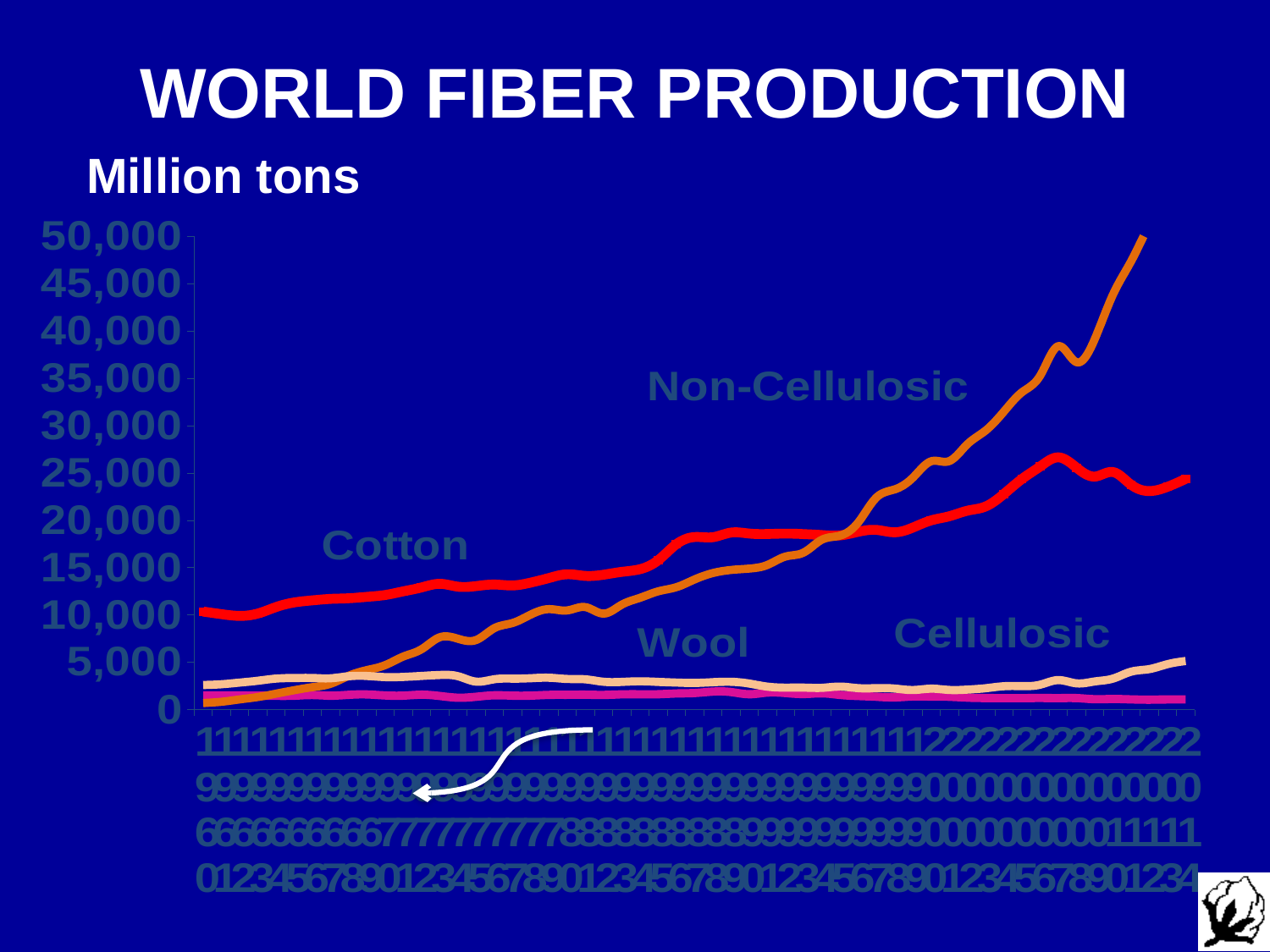
What kind of chart is shown on the slide? line chart At the right end of the chart, which is higher, Non-Cellulosic or Cotton? Non-Cellulosic What is the title of the chart? WORLD FIBER PRODUCTION Which series has the lowest values at the right end of the chart? Wool Does the Non-Cellulosic line rise or fall overall from left to right? rise Is the value of the Non-Cellulosic line at the left end of the chart greater or less than 5,000? less Which series reaches the highest value on the chart? Non-Cellulosic Is the value of the Cotton line at the left end of the chart greater or less than 5,000? greater Is the Wool line ever greater or less than 5,000 across the chart? less What unit is given for the y axis? Million tons How many fiber series are plotted on the chart? 4